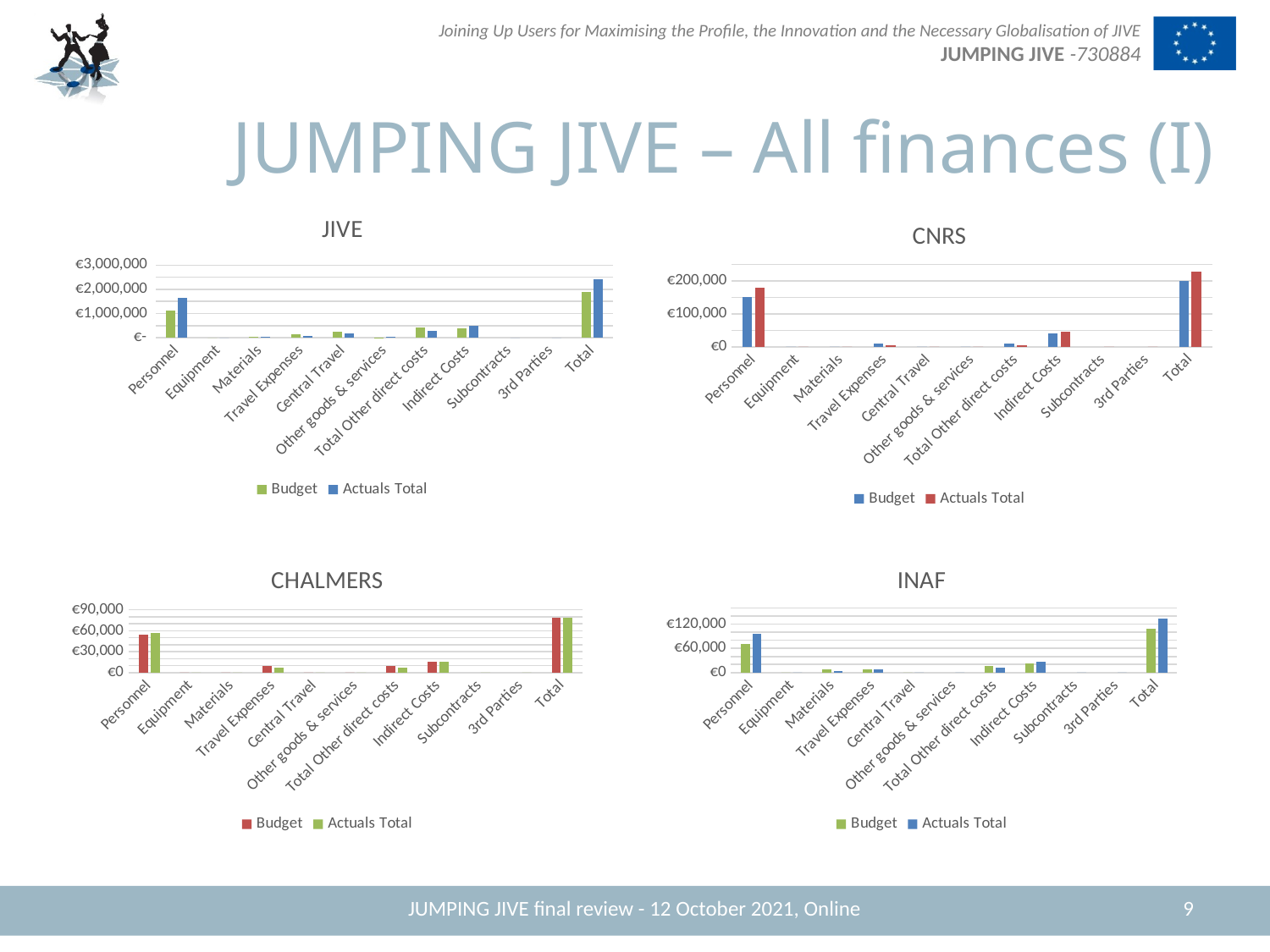
In the INAF chart, is the Actuals Total value for Total greater or less than €120,000? greater In the CHALMERS chart, is the Budget value for Total greater or less than €90,000? less In the INAF chart, which category has the highest Actuals Total value? Total How many categories are shown on the x axis of the CNRS chart? 11 What are the two legend entries in the INAF chart? Budget and Actuals Total In the CHALMERS chart, is the Budget value for Indirect Costs greater or less than €30,000? less How many series does the legend of the CHALMERS chart list? 2 What kind of chart is the JIVE chart? bar chart In the CNRS chart, which is larger for Personnel, Budget or Actuals Total? Actuals Total